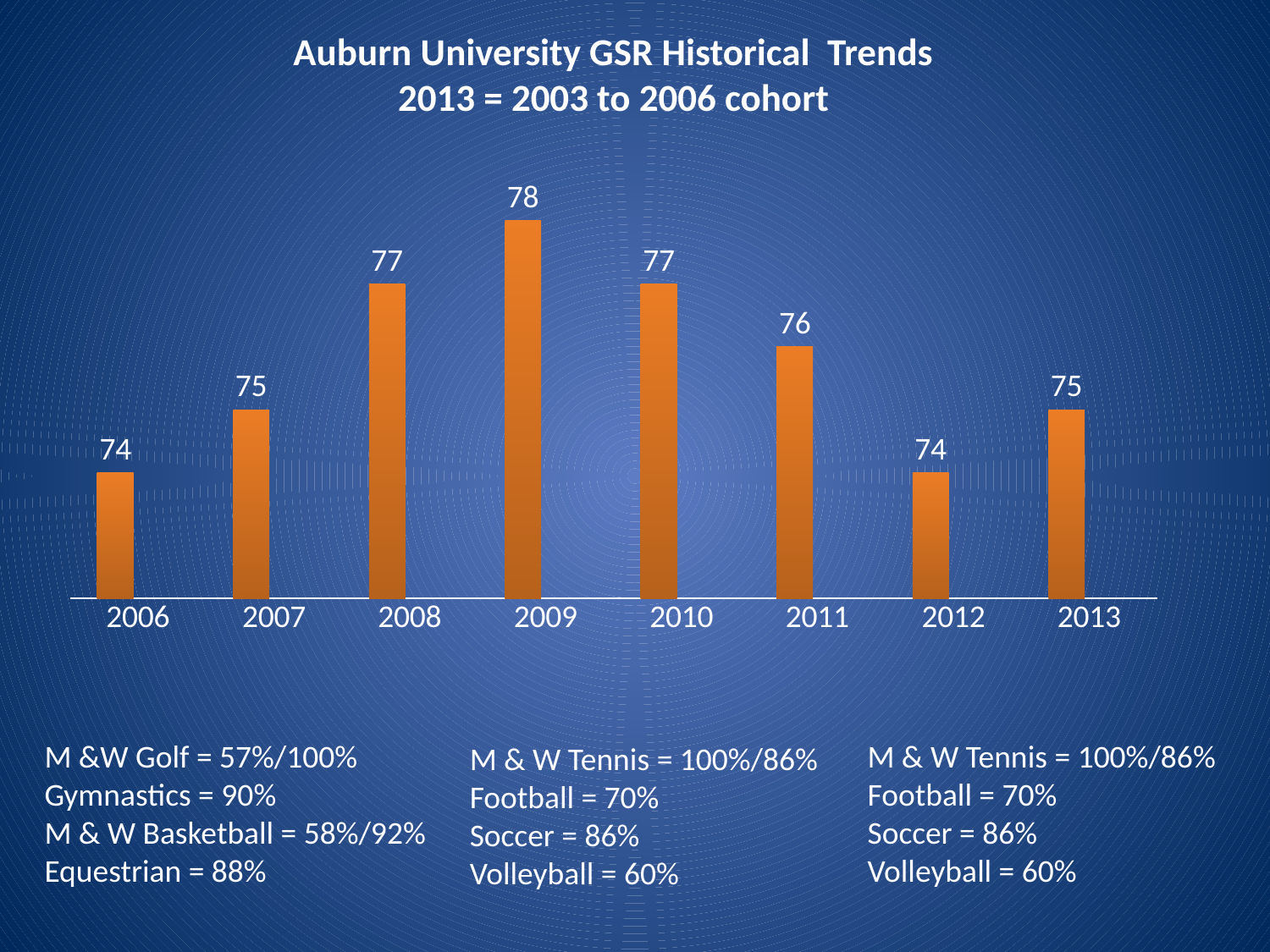
What is the difference between the values for 2009 and 2012? 4 What is the value for 2006? 74 What is the value for 2013? 75 How many years are shown on the x axis? 8 What is the value for 2011? 76 What is the value for 2009? 78 Which year has the highest value? 2009 What kind of chart is shown on the slide? Bar chart Which is larger, the value for 2010 or the value for 2011? 2010 What is the title of the chart? Auburn University GSR Historical Trends 2013 = 2003 to 2006 cohort Do the values rise or fall from 2006 to 2009? Rise What is the difference between the values for 2008 and 2007? 2